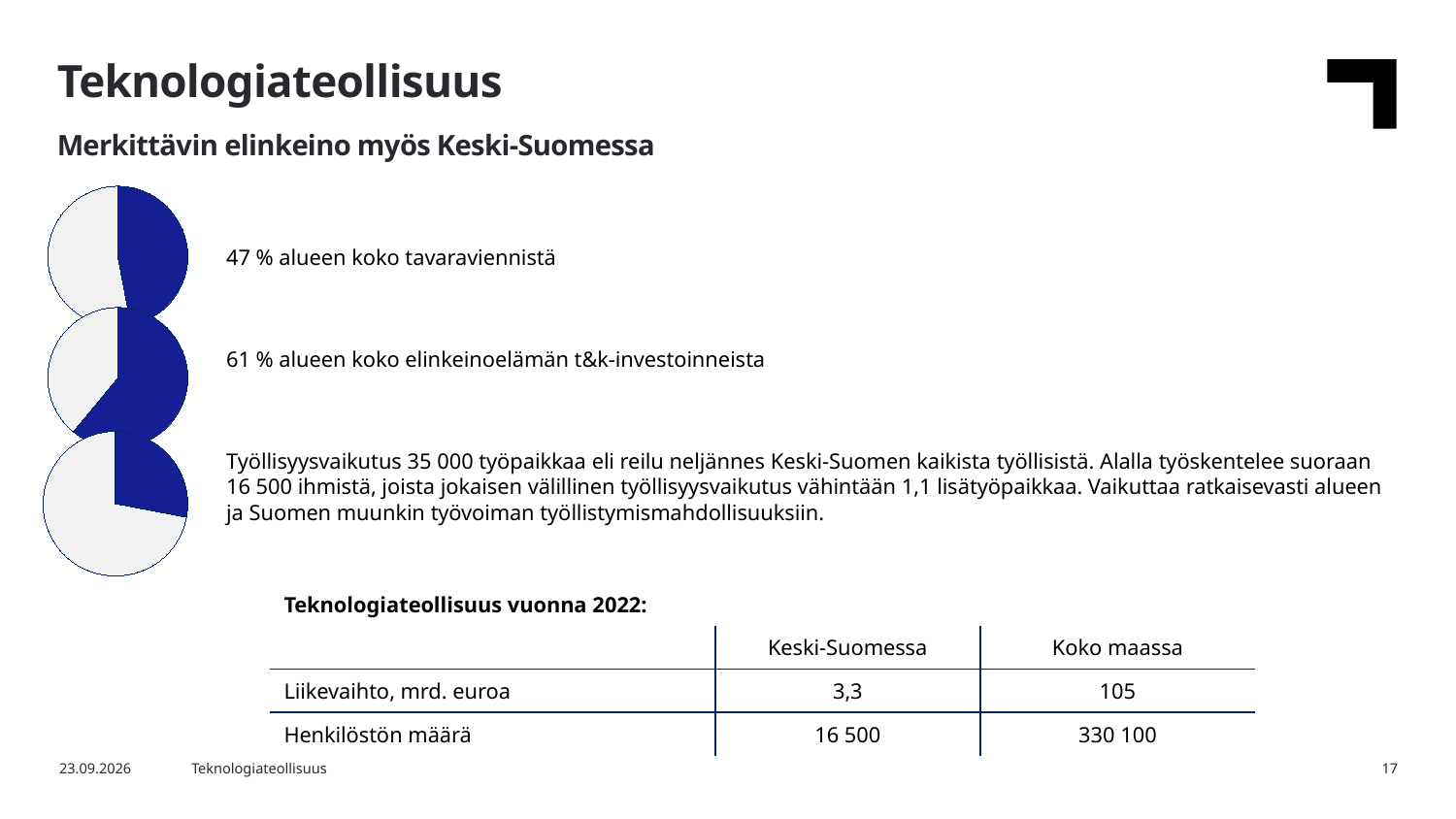
Which of the three pie charts has the largest dark blue slice? The middle one (t&k-investoinnit) Is the dark blue slice in the bottom pie chart greater or less than half of the pie? less How many pie charts are on the slide? 3 What colour is used for the highlighted slice in each pie chart? Dark blue Which pie chart has the larger dark blue slice, the top one (tavaravienti) or the middle one (t&k-investoinnit)? The middle one (t&k-investoinnit) According to the text next to the middle pie chart, what share of the region's business R&D investments does the technology industry account for? 61 % According to the text next to the top pie chart, what share of the region's total goods exports does the technology industry account for? 47 % Is the dark blue slice in the middle pie chart greater or less than half of the pie? greater What colour is the remaining (non-highlighted) part of each pie chart? Light grey Which of the three pie charts has the smallest dark blue slice? The bottom one (työllisyysvaikutus) What kind of charts are shown on the left side of the slide? Pie charts